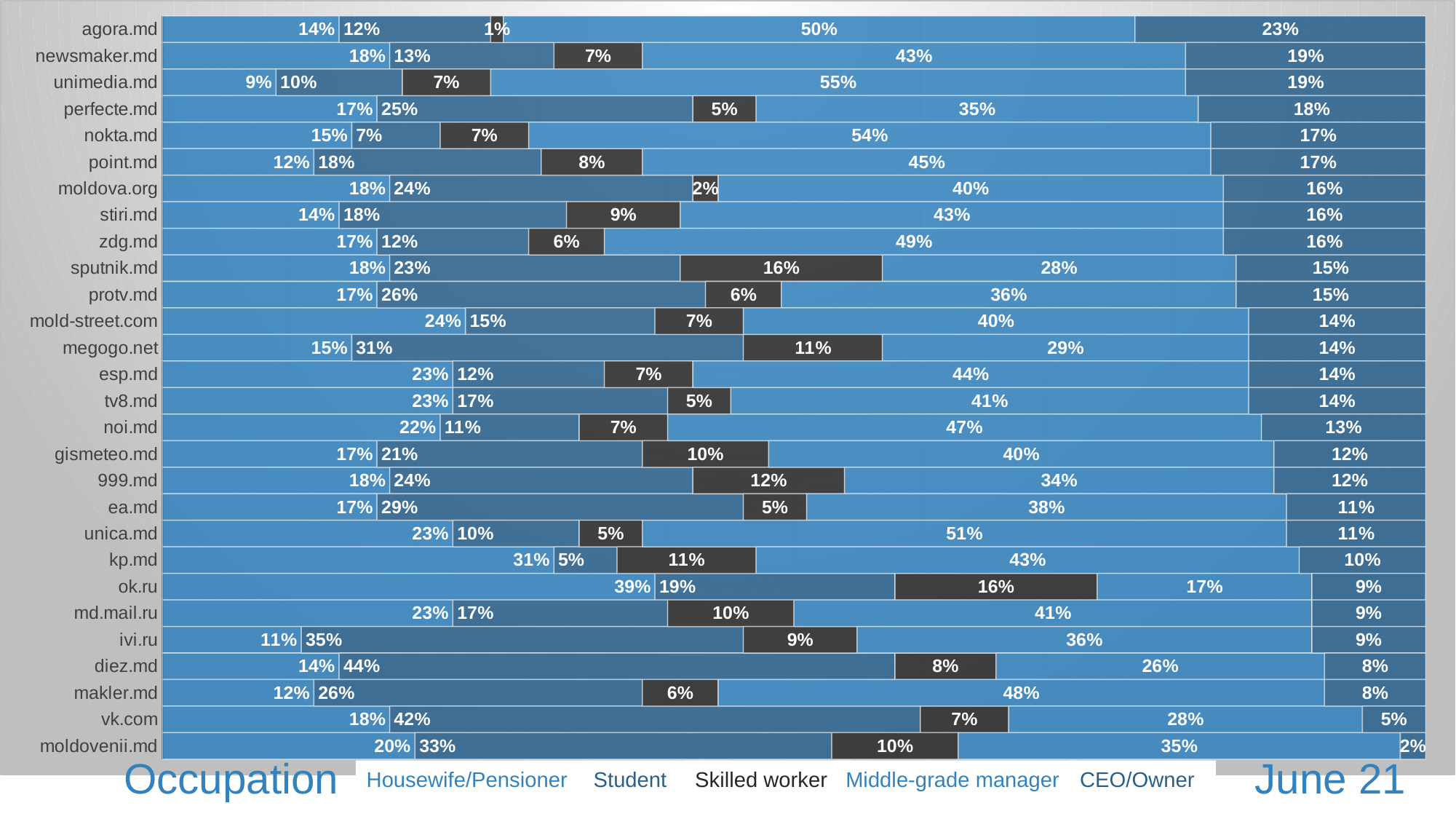
What kind of chart is shown on the slide? Stacked bar chart What is the CEO/Owner share for agora.md? 23% Which has a larger Housewife/Pensioner share, kp.md or ok.ru? ok.ru Which website has the highest CEO/Owner share? agora.md What is the Housewife/Pensioner share for ok.ru? 39% What is the difference in Middle-grade manager share between unimedia.md and ok.ru? 38 percentage points What is the Middle-grade manager share for unimedia.md? 55% How many series does the legend list? 5 Which website has the highest Student share? diez.md How many websites are listed on the chart? 28 What date is shown at the bottom right of the slide? June 21 Which website has the lowest CEO/Owner share? moldovenii.md